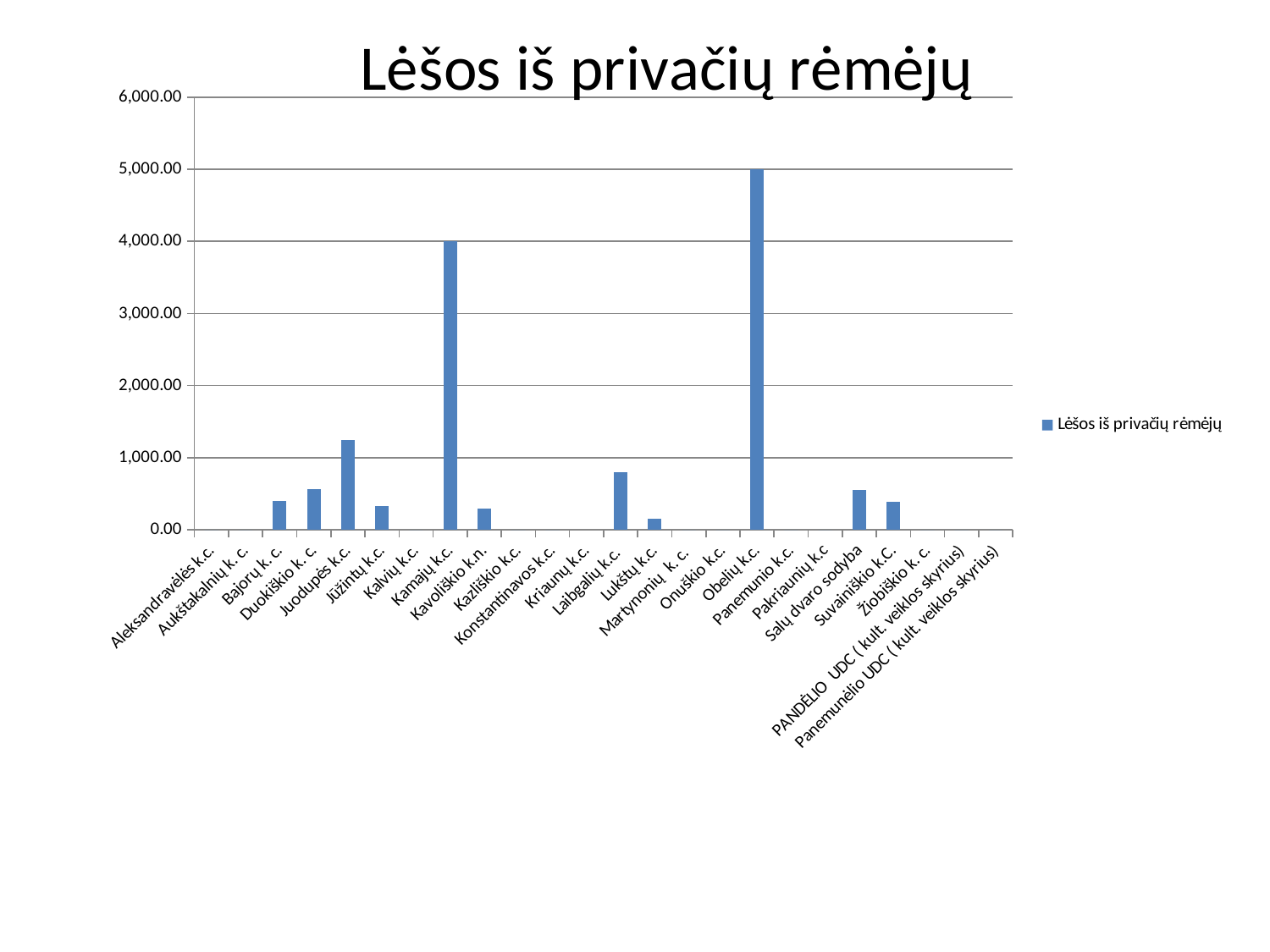
Is the value for Lukštų k.c. greater or less than 1,000.00? less What is the value for Obelių k.c.? 5,000.00 What is the value for Kamajų k.c.? 4,000.00 Which category has the highest value? Obelių k.c. How many categories are shown on the x axis? 24 How many series does the legend list? 1 What kind of chart is shown on the slide? Bar chart Which is larger, the value for Laibgalių k.c. or the value for Lukštų k.c.? Laibgalių k.c. What is the title of the chart? Lėšos iš privačių rėmėjų Is the value for Juodupės k.c. greater or less than 1,000.00? greater Is the value for Laibgalių k.c. greater or less than 1,000.00? less Which is larger, the value for Kamajų k.c. or the value for Juodupės k.c.? Kamajų k.c.